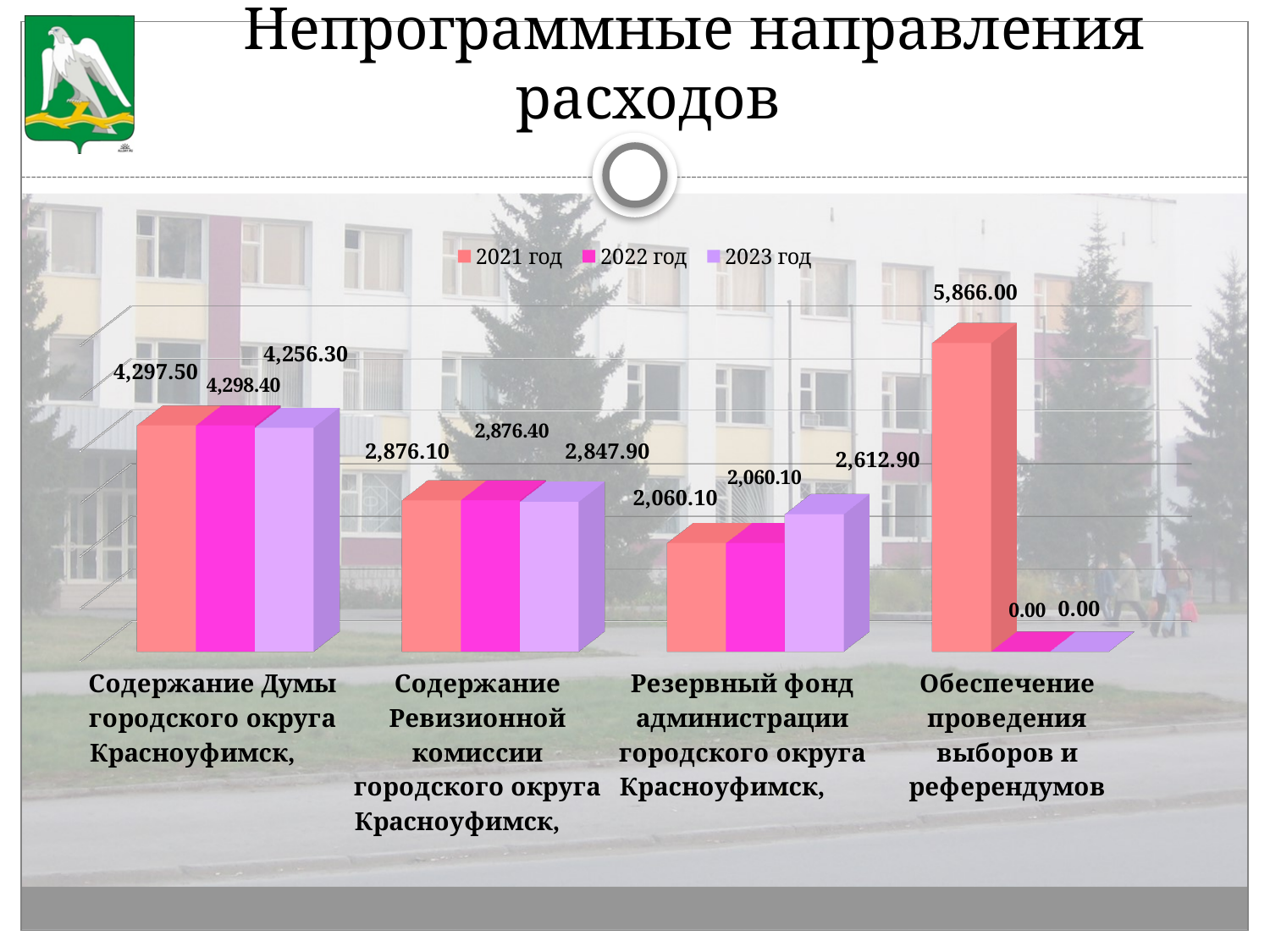
Which category has the highest value for 2021 год? Обеспечение проведения выборов и референдумов What is the value for 2023 год for Резервный фонд администрации городского округа Красноуфимск? 2,612.90 What is the value for 2021 год for Обеспечение проведения выборов и референдумов? 5,866.00 What is the value for 2021 год for Содержание Думы городского округа Красноуфимск? 4,297.50 What is the title of the slide? Непрограммные направления расходов What is the value for 2022 год for Содержание Ревизионной комиссии городского округа Красноуфимск? 2,876.40 How many categories are shown on the x axis? 4 Which is larger for Содержание Думы городского округа Красноуфимск: the 2021 год value or the 2023 год value? 2021 год What kind of chart is shown on the slide? Bar chart Which category has the lowest value for 2023 год? Обеспечение проведения выборов и референдумов How many series does the legend list? 3 What is the difference between the 2023 год and 2021 год values for Резервный фонд администрации городского округа Красноуфимск? 552.80